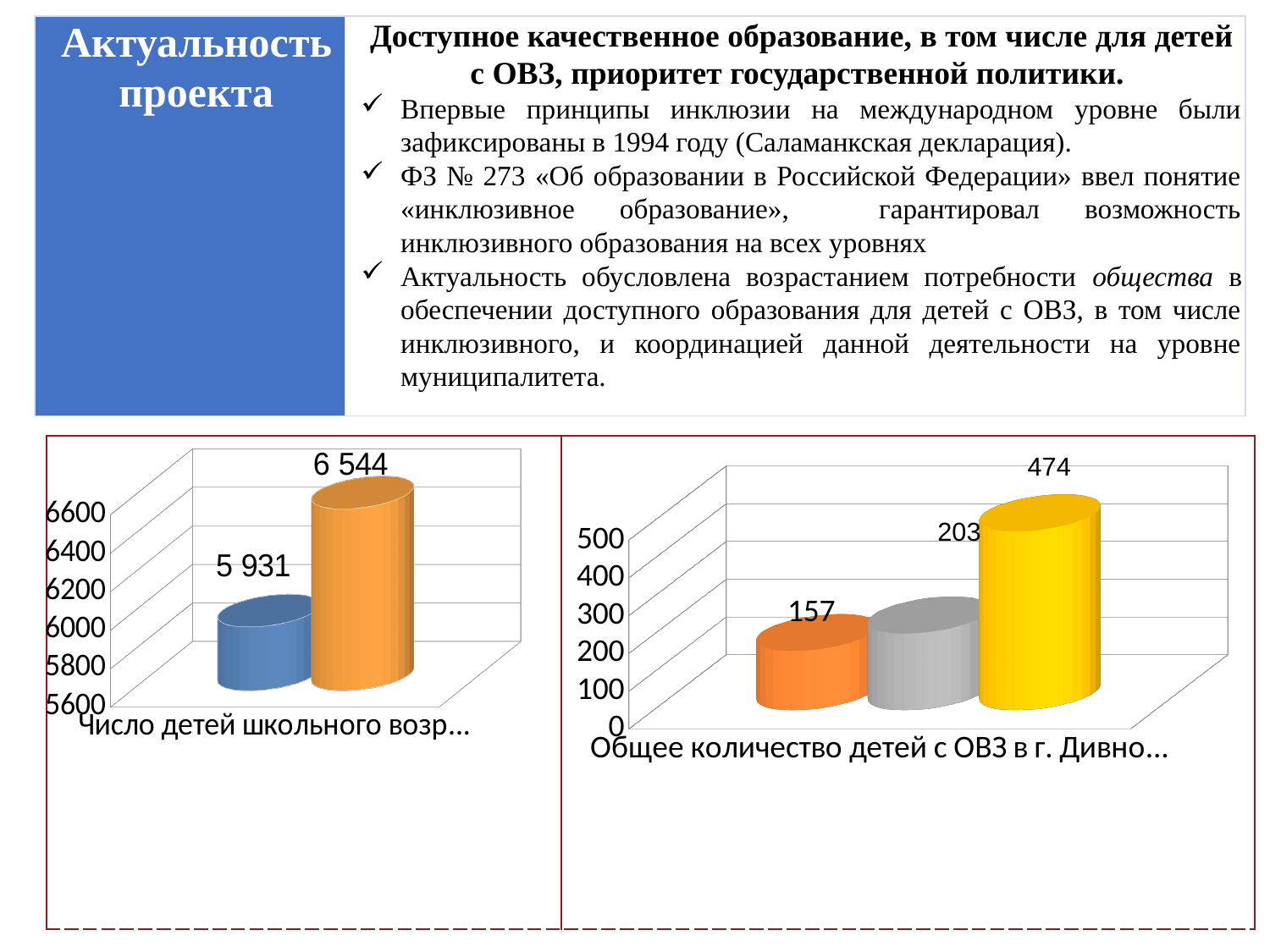
On the right chart, what value is shown on the yellow bar? 474 On the right chart, which bar has the highest value? the yellow bar (474) On the left chart, what value is shown on the orange bar? 6 544 On the right chart, do the values rise or fall from left to right? rise On the right chart, what value is shown on the orange bar? 157 On the right chart, what is the difference between the yellow bar (474) and the orange bar (157)? 317 What kind of chart is the left chart? bar chart On the left chart, what is the difference between the orange bar (6 544) and the blue bar (5 931)? 613 On the right chart, what value is shown on the grey bar? 203 On the left chart, which bar is taller, the blue one or the orange one? the orange one On the left chart, what value is shown on the blue bar? 5 931 On the left chart, how many bars are plotted? 2